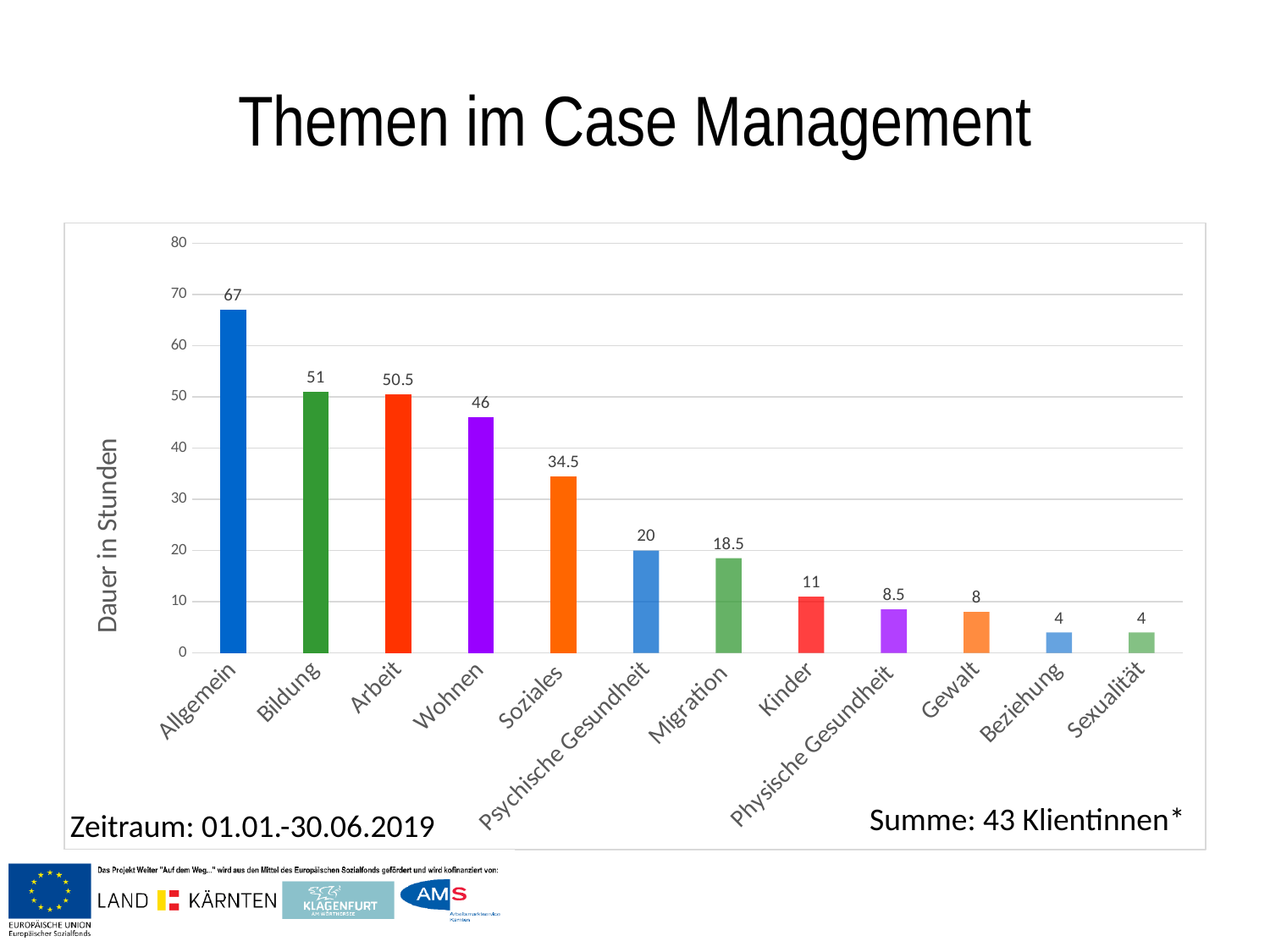
Which is larger, the value for Kinder or the value for Gewalt? Kinder Which category has the lowest value? Beziehung and Sexualität What is the value for Soziales? 34.5 What is the difference between the values for Bildung and Arbeit? 0.5 What kind of chart is shown? Bar chart What is the difference between the values for Wohnen and Psychische Gesundheit? 26 Which category has the highest value? Allgemein What is the value for Physische Gesundheit? 8.5 How many categories are shown on the x axis? 12 What is the value for Migration? 18.5 What is the value for Allgemein? 67 What is the label of the y axis? Dauer in Stunden